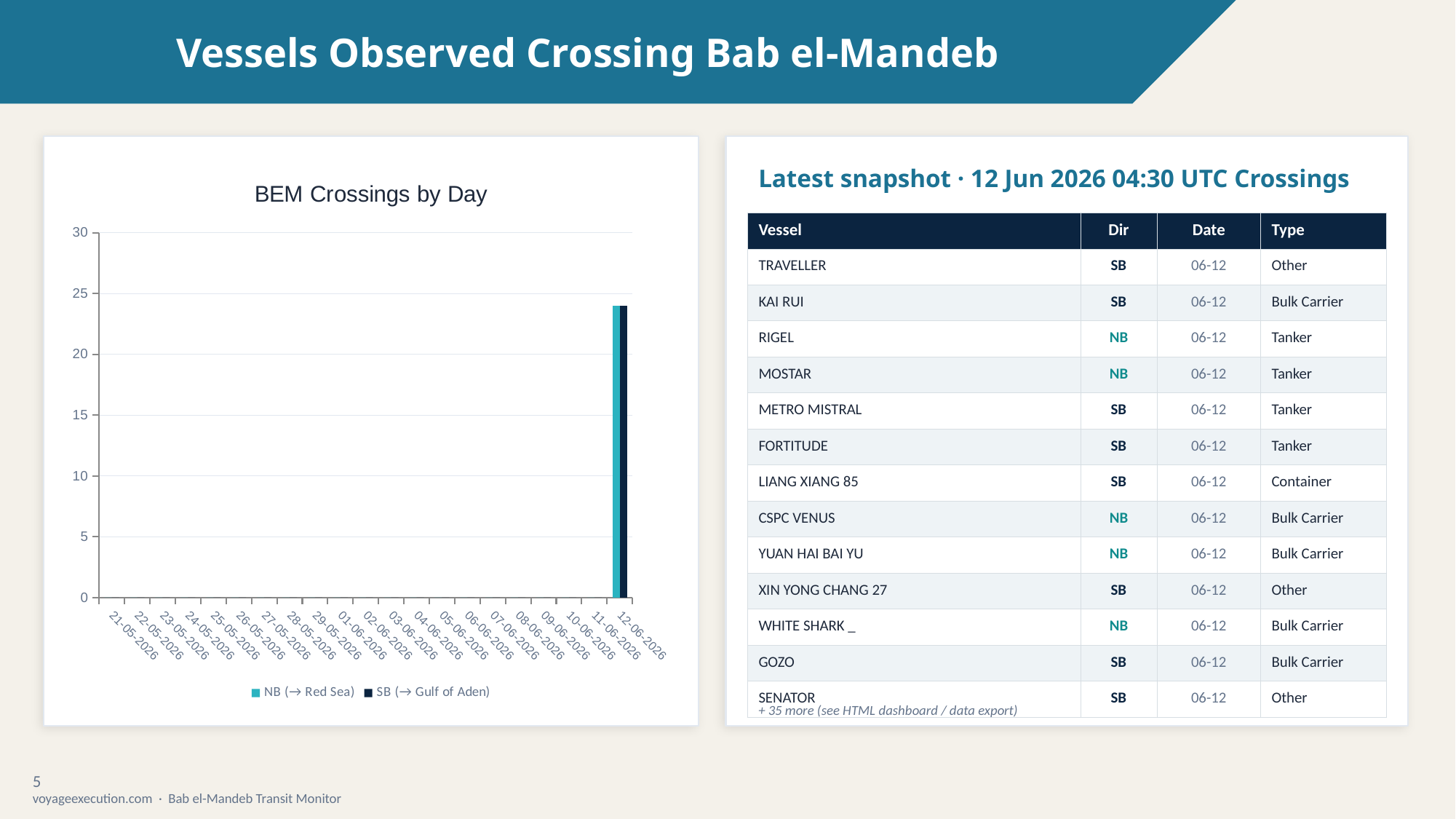
What kind of chart is "BEM Crossings by Day"? bar chart What is the first date shown on the x axis of "BEM Crossings by Day"? 21-05-2026 How many dates are shown on the x axis of "BEM Crossings by Day"? 21 How many series does the legend of "BEM Crossings by Day" list? 2 What are the two series named in the legend of "BEM Crossings by Day"? NB (→ Red Sea) and SB (→ Gulf of Aden) In "BEM Crossings by Day", is the SB (→ Gulf of Aden) value for 11-06-2026 greater or less than 5? less In "BEM Crossings by Day", is the SB (→ Gulf of Aden) value for 12-06-2026 greater or less than 20? greater What is the highest value shown on the y axis of "BEM Crossings by Day"? 30 In "BEM Crossings by Day", is the NB (→ Red Sea) value for 12-06-2026 greater or less than 20? greater In "BEM Crossings by Day", which date has the highest number of crossings? 12-06-2026